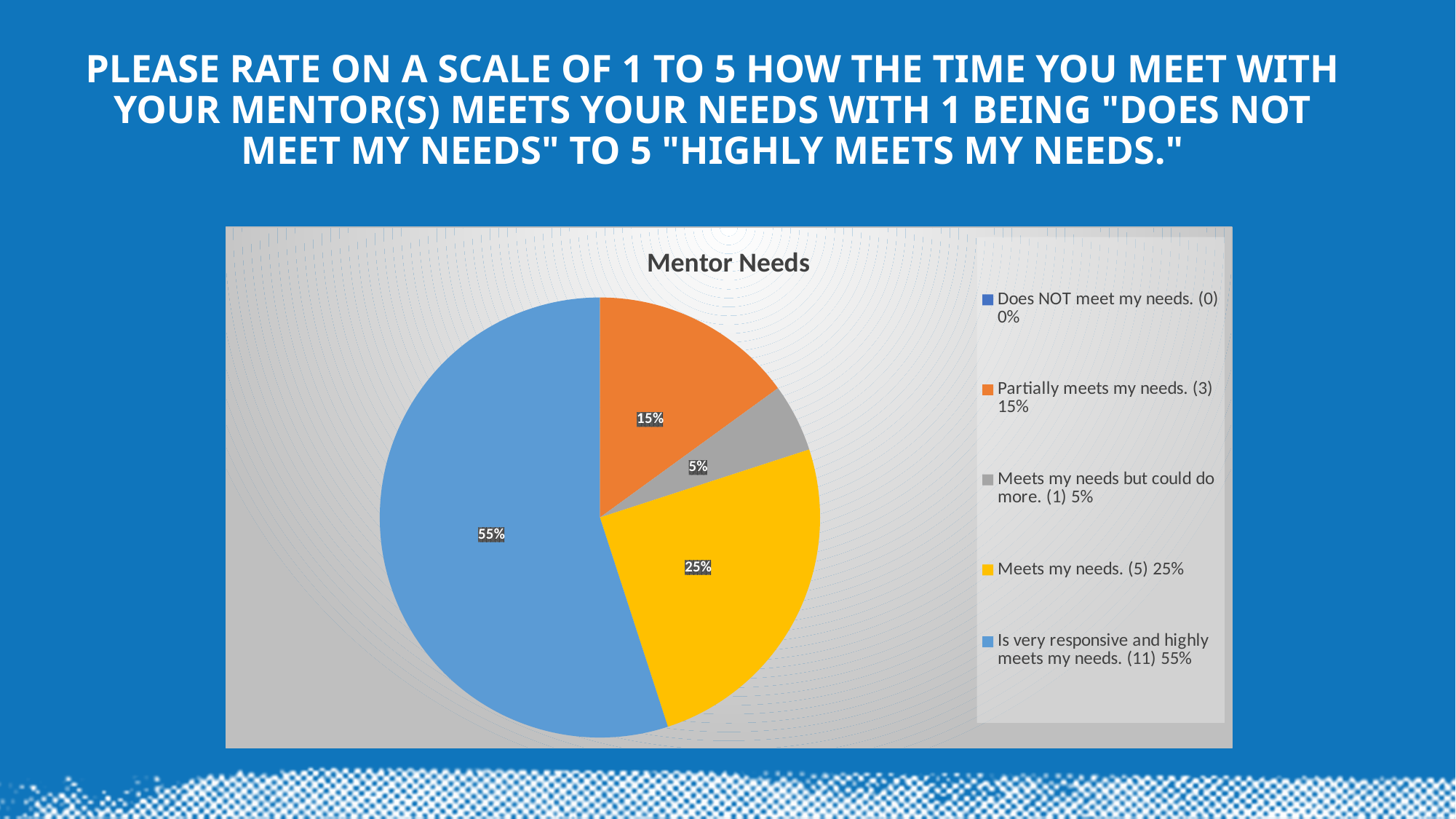
What percentage of the pie is 'Is very responsive and highly meets my needs.'? 55% What is the difference in percentage points between 'Is very responsive and highly meets my needs.' and 'Meets my needs.'? 30 Which is larger: the share for 'Partially meets my needs.' or the share for 'Meets my needs.'? Meets my needs. How many categories does the legend list? 5 What percentage of the pie is 'Meets my needs.'? 25% Which category has the smallest share of the pie? Does NOT meet my needs. What percentage of the pie is 'Meets my needs but could do more.'? 5% How many responses does the legend show for 'Meets my needs.'? 5 What percentage of the pie is 'Partially meets my needs.'? 15% What type of chart is shown on the slide? pie chart What is the title of the chart? Mentor Needs Which category has the largest share of the pie? Is very responsive and highly meets my needs.